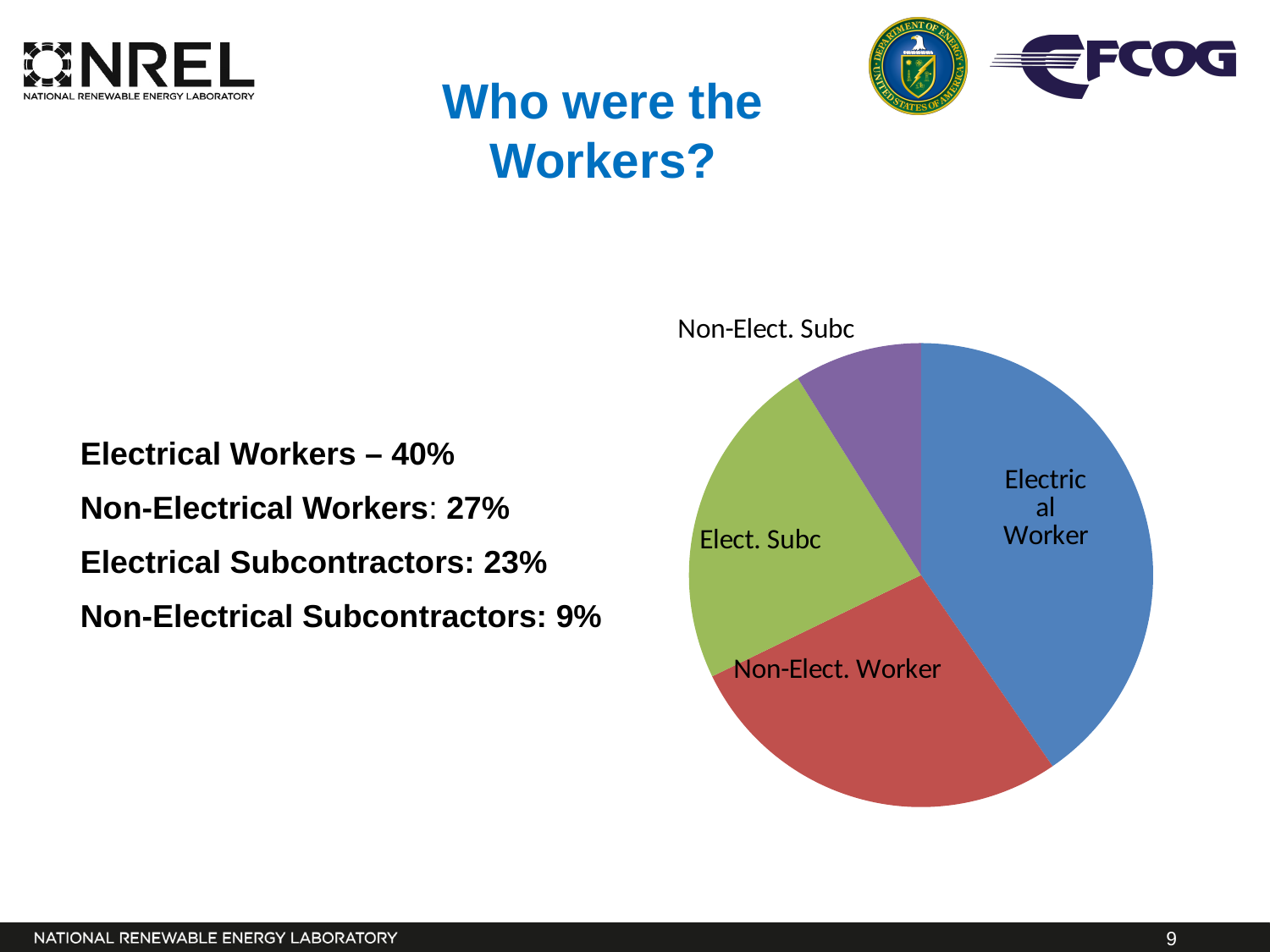
What kind of chart is shown on the slide? pie chart What is the difference in percentage points between the Non-Electrical Workers share and the Electrical Subcontractors share? 4% Which slice of the pie chart is the largest? Electrical Worker What share of the pie do Electrical Workers represent? 40% Which is larger in the pie chart, the Non-Elect. Worker slice or the Elect. Subc slice? Non-Elect. Worker What share of the pie do Electrical Subcontractors represent? 23% What colour is the Electrical Worker slice of the pie chart? blue How many slices does the pie chart have? 4 What share of the pie do Non-Electrical Workers represent? 27% Which slice of the pie chart is the smallest? Non-Elect. Subc What is the difference in percentage points between the Electrical Workers share and the Non-Electrical Subcontractors share? 31%